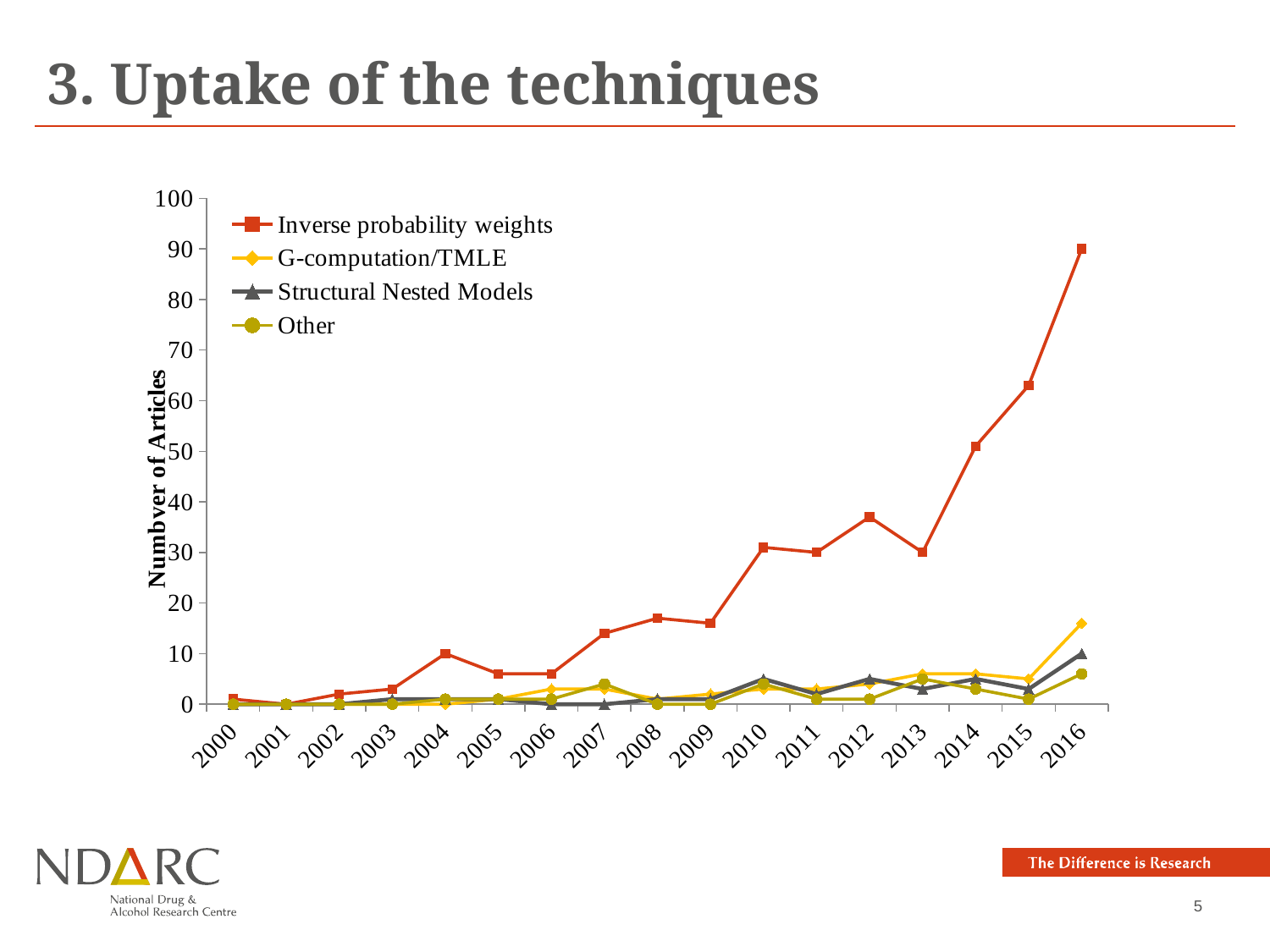
How many years are plotted along the x axis? 17 What is the number of articles for Inverse probability weights in 2013? 30 Is the value for Inverse probability weights in 2015 greater or less than 60? greater How many series does the legend list? 4 Is the value for G-computation/TMLE in 2016 greater or less than 20? less Is the value for Inverse probability weights in 2012 greater or less than 30? greater Which series has the larger value in 2016, Inverse probability weights or Structural Nested Models? Inverse probability weights What kind of chart is shown on the slide? line chart What is the number of articles for Inverse probability weights in 2016? 90 In which year does the Inverse probability weights series reach its highest value? 2016 What is the number of articles for Inverse probability weights in 2004? 10 Does the Inverse probability weights series generally rise or fall from 2000 to 2016? rise